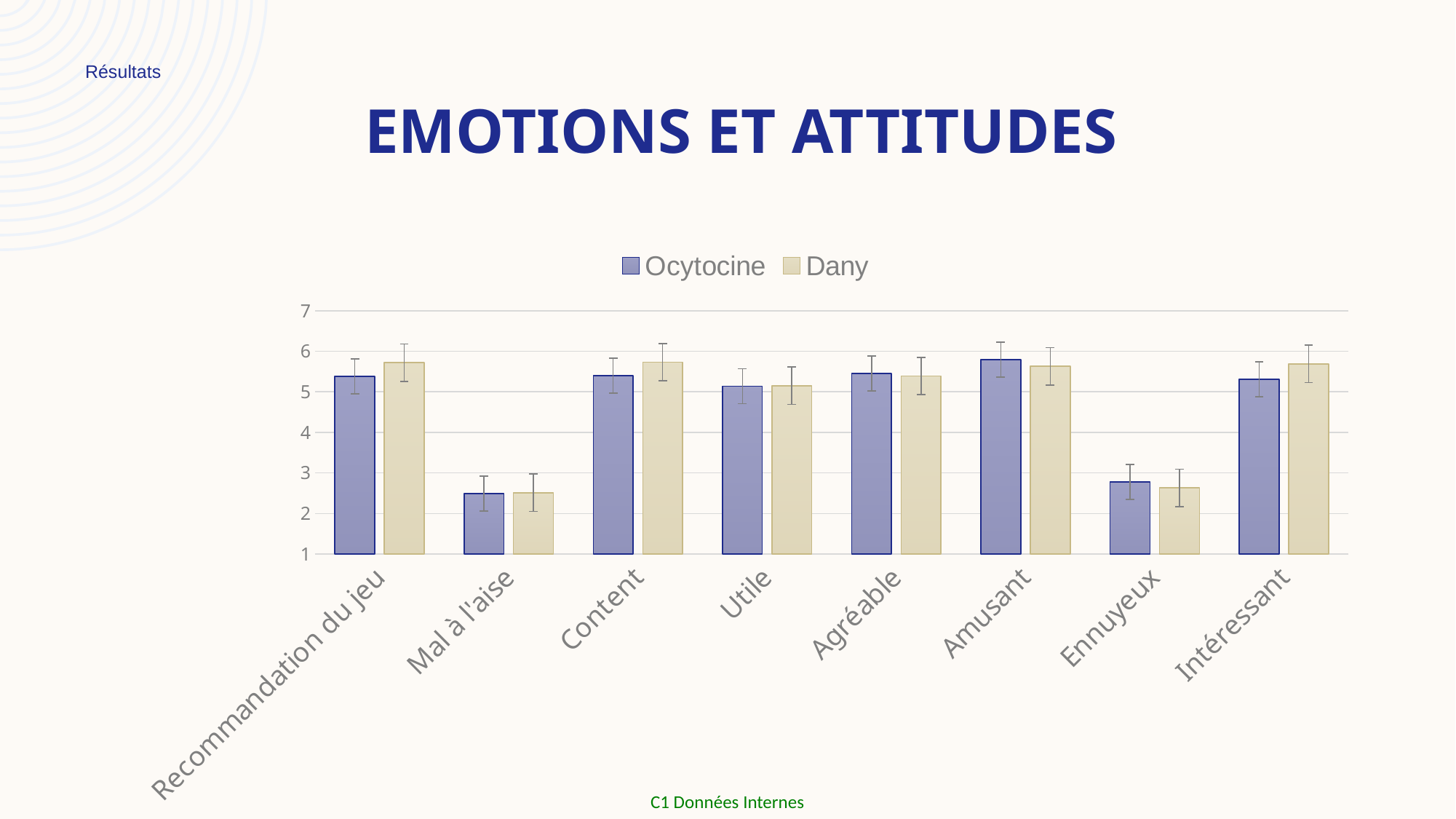
Is the Dany value for Intéressant greater or less than 5? greater For which category is the Ocytocine value highest? Amusant How many categories are shown on the x axis of the chart? 8 For which category is the Ocytocine value lowest? Mal à l'aise What is the title of the slide containing the chart? EMOTIONS ET ATTITUDES Is the Ocytocine value for Ennuyeux greater or less than 3? less Is the Ocytocine value for Mal à l'aise greater or less than 3? less For Recommandation du jeu, which series has the larger value, Ocytocine or Dany? Dany For Intéressant, which series has the larger value, Ocytocine or Dany? Dany Which series are listed in the chart legend? Ocytocine and Dany What kind of chart is shown on the slide? bar chart How many series does the chart legend list? 2